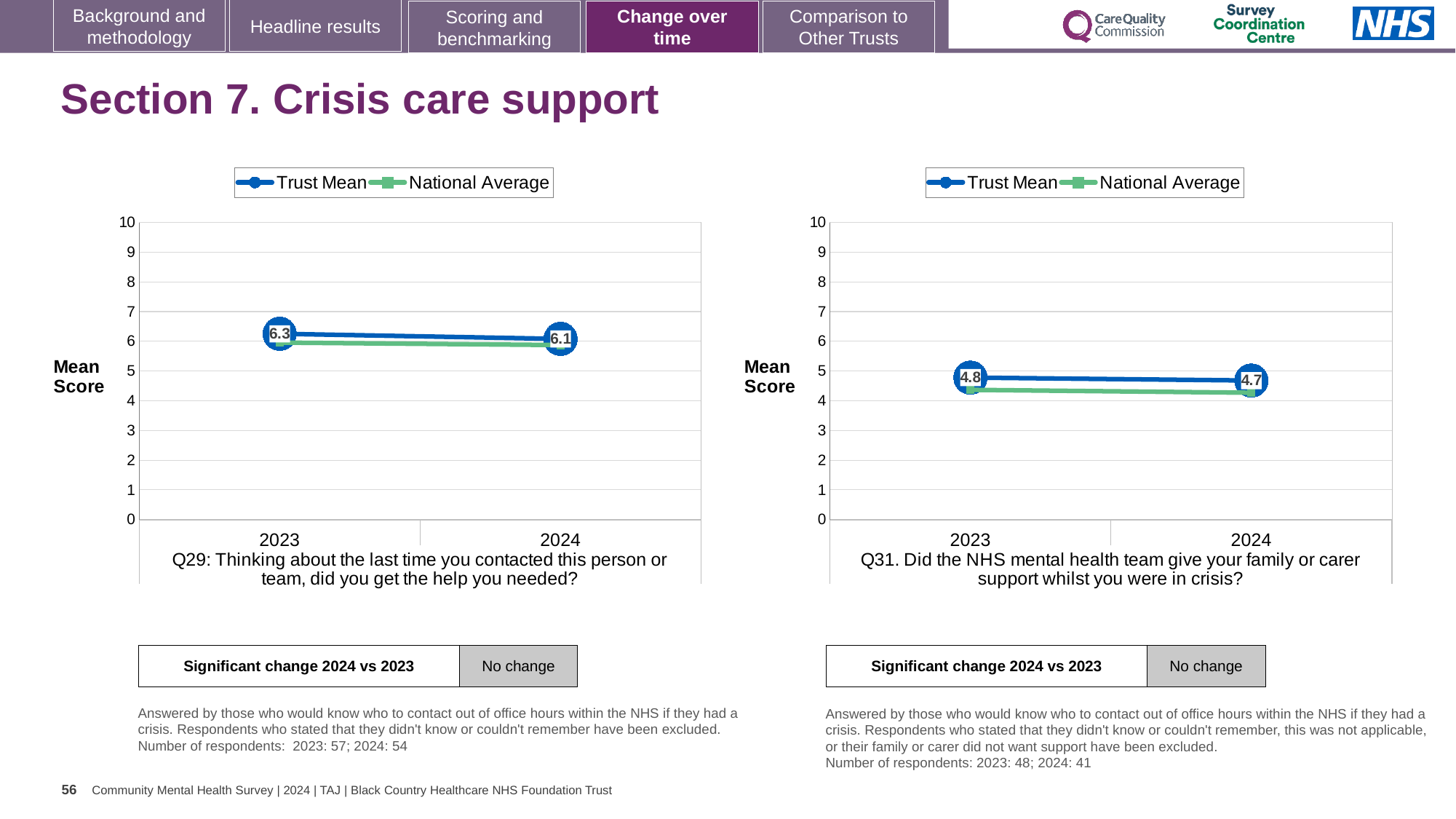
What is the y-axis label on the Q31 chart on the right? Mean Score In the Q31 chart on the right, what is the Trust Mean score for 2023? 4.8 In the Q29 chart on the left, what is the Trust Mean score for 2024? 6.1 What kind of chart is the Q29 chart on the left? line chart In the Q31 chart on the right, does the Trust Mean rise or fall from 2023 to 2024? fall In the Q29 chart on the left, what is the Trust Mean score for 2023? 6.3 How many years are plotted on the x axis of the Q31 chart on the right? 2 How many series does the legend of the Q29 chart on the left list? 2 In the Q31 chart on the right, what is the Trust Mean score for 2024? 4.7 In the Q31 chart on the right, is the National Average for 2023 greater or less than 5? less In the Q29 chart on the left, by how much did the Trust Mean change from 2023 to 2024? 0.2 In the Q29 chart on the left, which series is higher in 2023, Trust Mean or National Average? Trust Mean